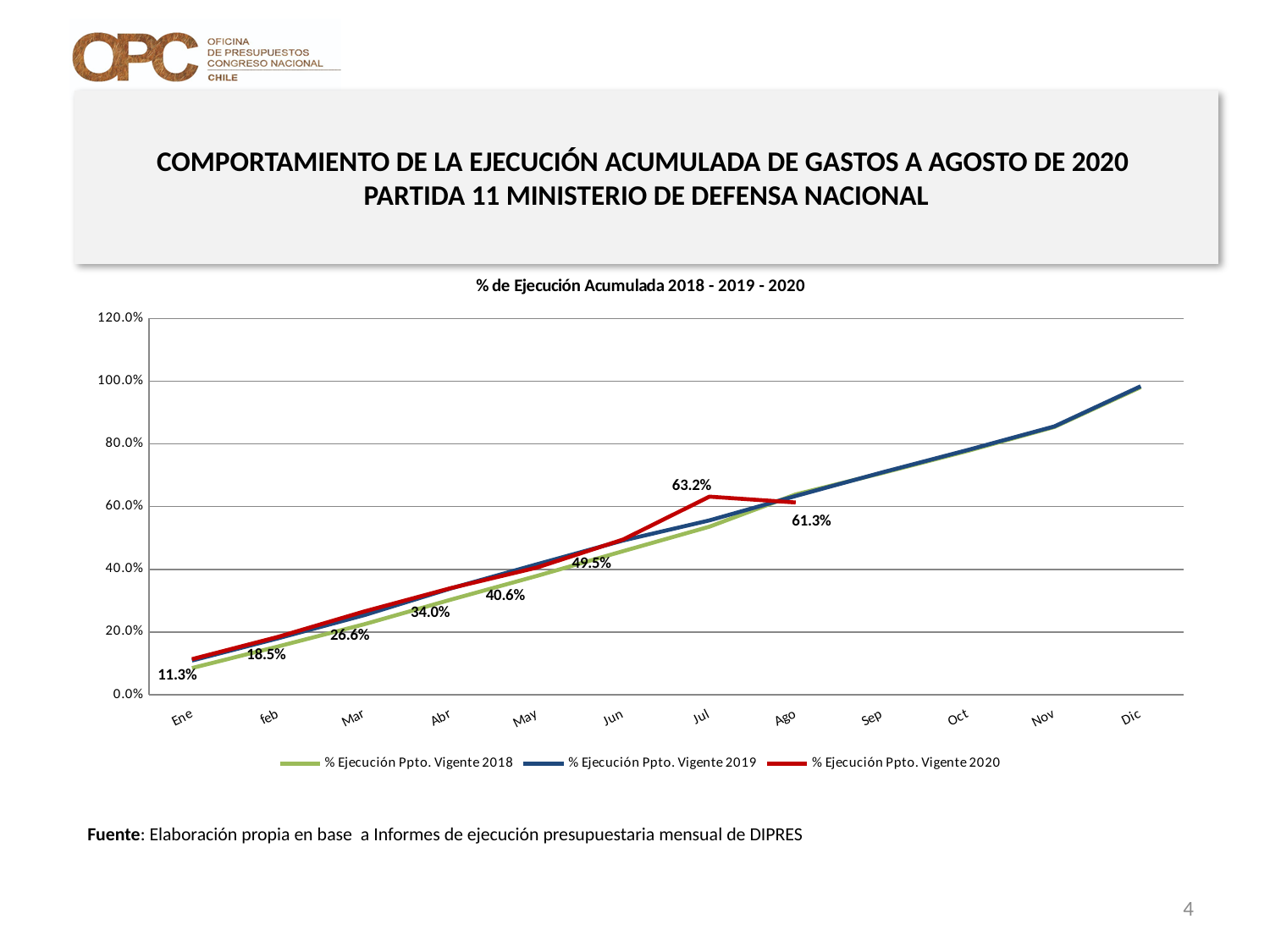
What kind of chart is shown on the slide? line chart For % Ejecución Ppto. Vigente 2020, which is larger: the Jul value or the Ago value? Jul What is the title of the chart? % de Ejecución Acumulada 2018 - 2019 - 2020 In which month does the % Ejecución Ppto. Vigente 2020 series reach its highest value? Jul What is the value of % Ejecución Ppto. Vigente 2020 in Ago? 61.3% How many series does the legend list? 3 What is the value of % Ejecución Ppto. Vigente 2020 in Jul? 63.2% What is the value of % Ejecución Ppto. Vigente 2020 in Ene? 11.3% How many months are shown along the x axis? 12 What is the value of % Ejecución Ppto. Vigente 2020 in Abr? 34.0% What is the difference between the Jul and Jun values of % Ejecución Ppto. Vigente 2020? 13.7 percentage points Is the value of % Ejecución Ppto. Vigente 2019 in Dic greater or less than 80.0%? greater